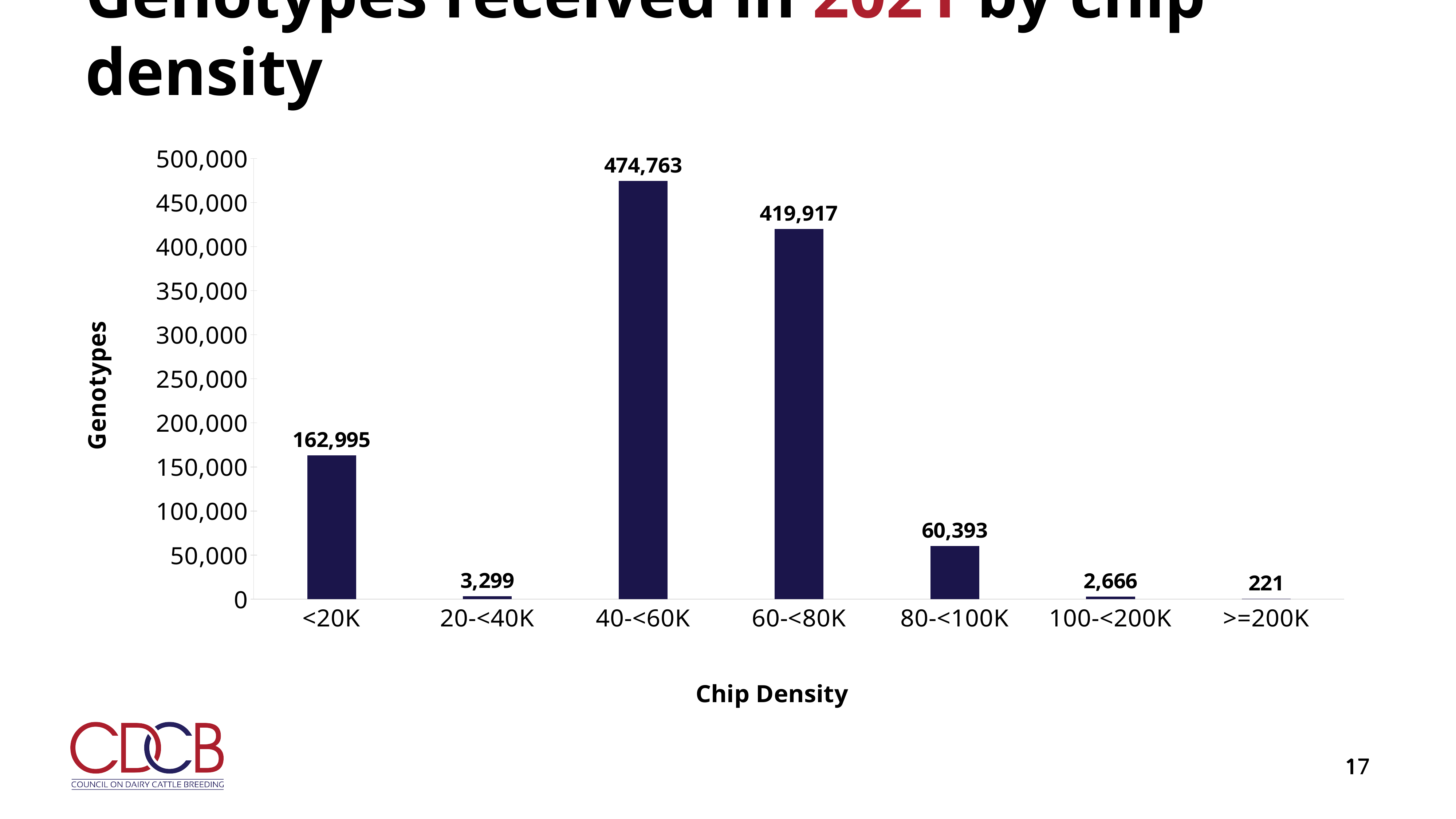
What is the number of genotypes for the >=200K chip density? 221 What is the difference in genotypes between the 40-<60K and 60-<80K categories? 54,846 What is the number of genotypes for the <20K chip density? 162,995 What is the number of genotypes for the 80-<100K chip density? 60,393 What kind of chart is shown on the slide? Bar chart How many chip density categories are shown on the chart? 7 Which has more genotypes, the <20K category or the 80-<100K category? <20K Which chip density category has the highest number of genotypes? 40-<60K What is the difference in genotypes between the 20-<40K and 100-<200K categories? 633 Which chip density category has the lowest number of genotypes? >=200K What is the number of genotypes for the 40-<60K chip density? 474,763 Is the value for 60-<80K greater or less than 400,000? greater